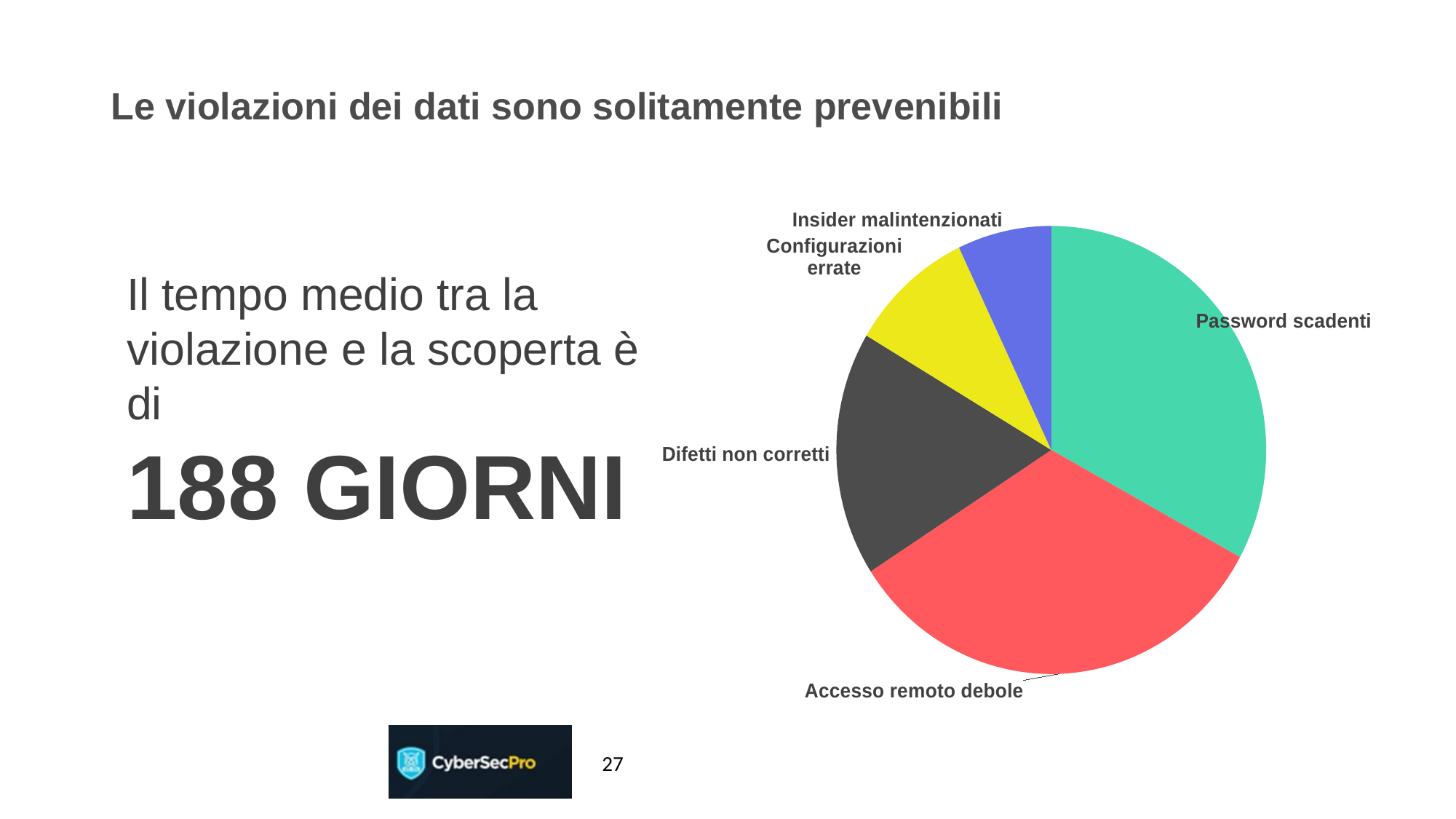
Which category has the smallest slice in the pie chart? Insider malintenzionati What colour is the Accesso remoto debole slice in the pie chart? red What kind of chart is shown on the slide? pie chart How many slices does the pie chart have? 5 Which slice is larger, Password scadenti or Difetti non corretti? Password scadenti Which slice is larger, Difetti non corretti or Insider malintenzionati? Difetti non corretti Which slice is larger, Accesso remoto debole or Configurazioni errate? Accesso remoto debole Which category is shown by the yellow slice of the pie chart? Configurazioni errate